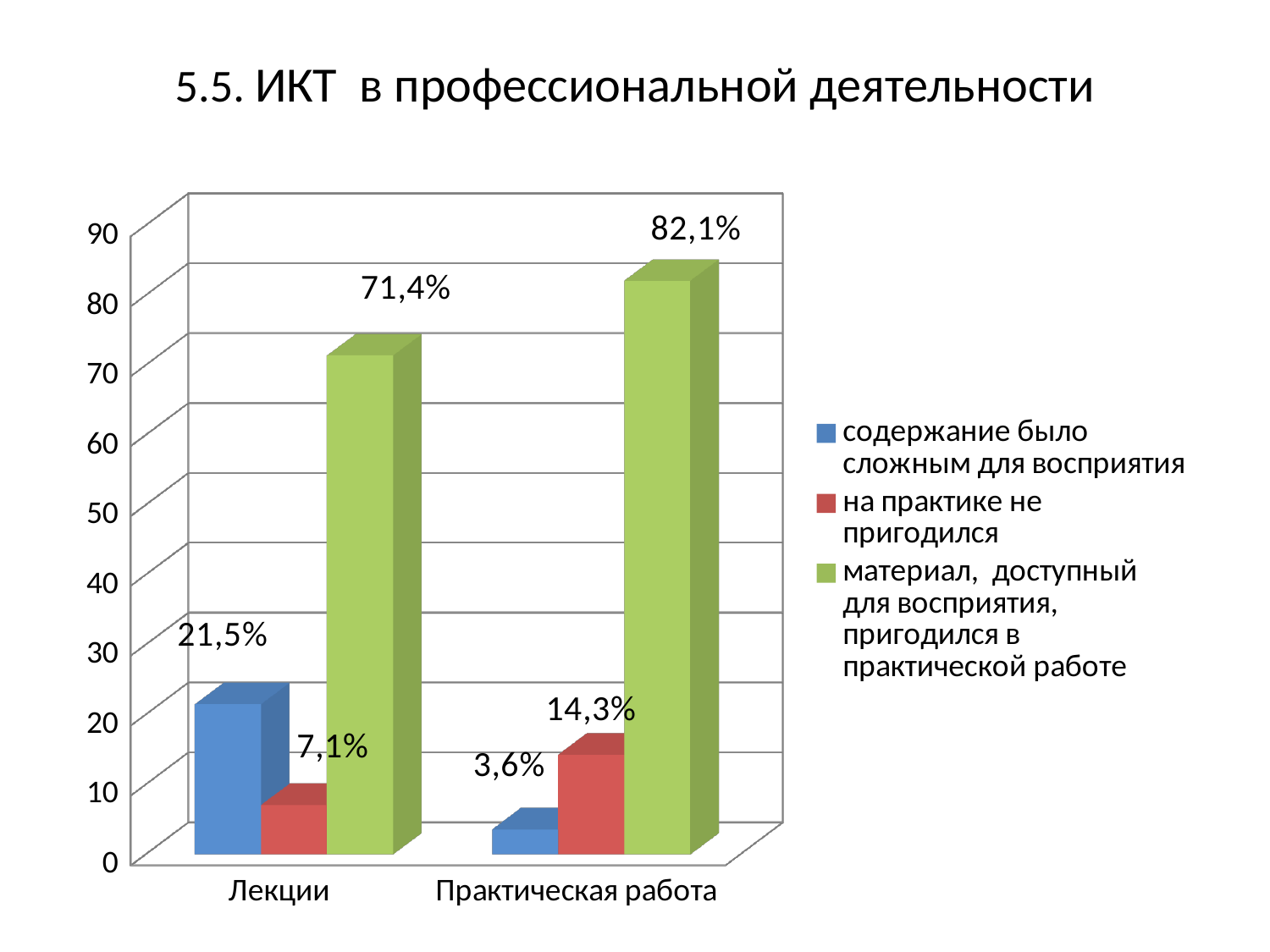
What is the value for "содержание было сложным для восприятия" in the "Практическая работа" category? 3,6% How many categories are shown on the x axis? 2 What is the value for "материал, доступный для восприятия, пригодился в практической работе" in the "Практическая работа" category? 82,1% What is the value for "содержание было сложным для восприятия" in the "Лекции" category? 21,5% Which series has the lowest value in the "Практическая работа" category? содержание было сложным для восприятия What is the value for "на практике не пригодился" in the "Практическая работа" category? 14,3% Which series has the highest value in the "Лекции" category? материал, доступный для восприятия, пригодился в практической работе What kind of chart is shown on the slide? bar chart What is the difference between the "материал, доступный для восприятия, пригодился в практической работе" values for "Практическая работа" and "Лекции"? 10,7% Which is larger: the "на практике не пригодился" value for "Лекции" or for "Практическая работа"? Практическая работа What is the value for "материал, доступный для восприятия, пригодился в практической работе" in the "Лекции" category? 71,4% How many series does the legend list? 3